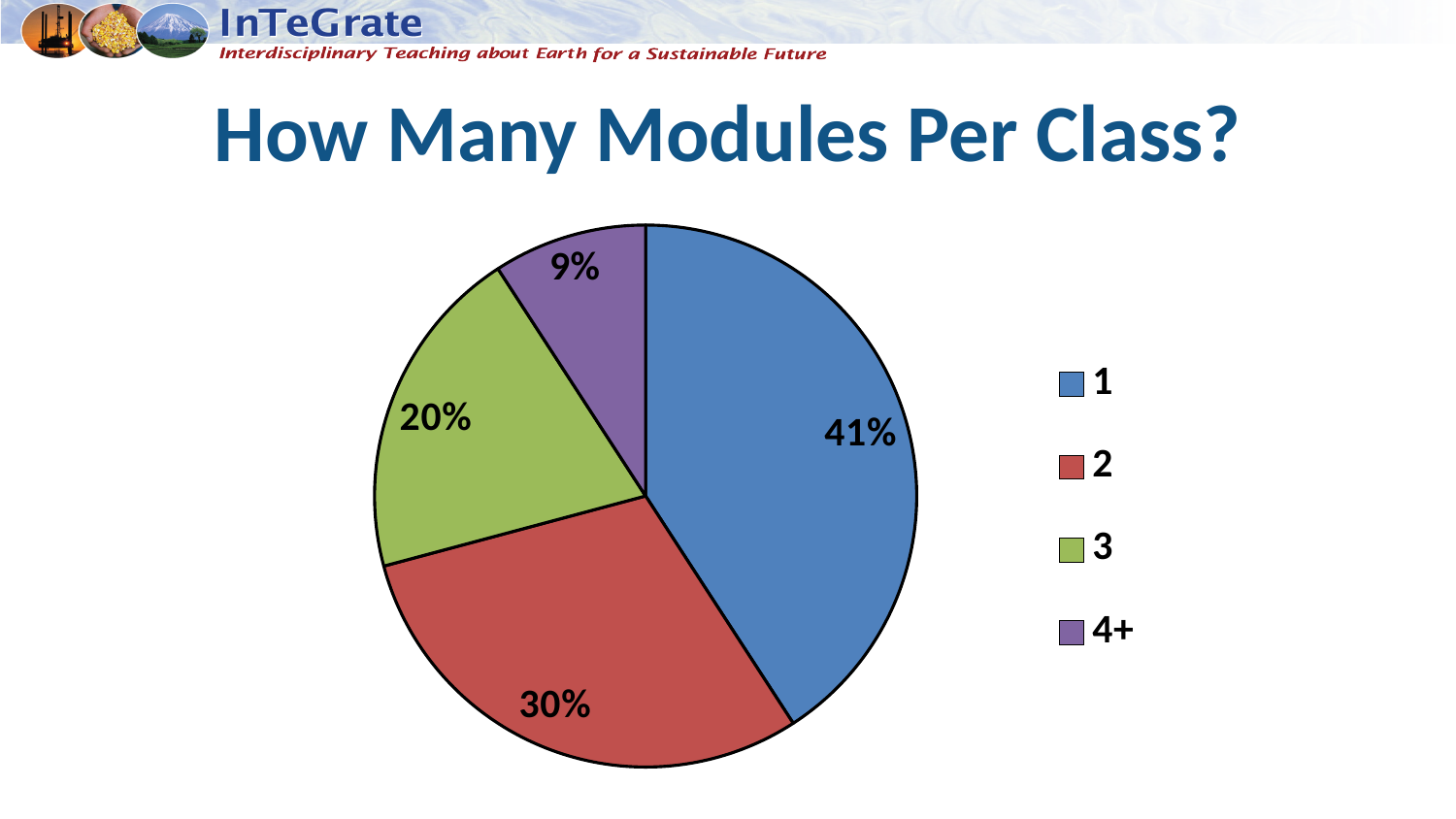
What kind of chart is shown on the slide? pie chart What share of the pie does the category "2" have? 30% What is the title of the chart? How Many Modules Per Class? Which slice is larger, "2" or "3"? 2 What share of the pie does the category "4+" have? 9% What share of the pie does the category "3" have? 20% What is the difference in percentage points between the "1" slice and the "2" slice? 11 How many categories does the pie chart have? 4 What is the difference in percentage points between the "3" slice and the "4+" slice? 11 Which category has the smallest slice of the pie? 4+ Which category has the largest slice of the pie? 1